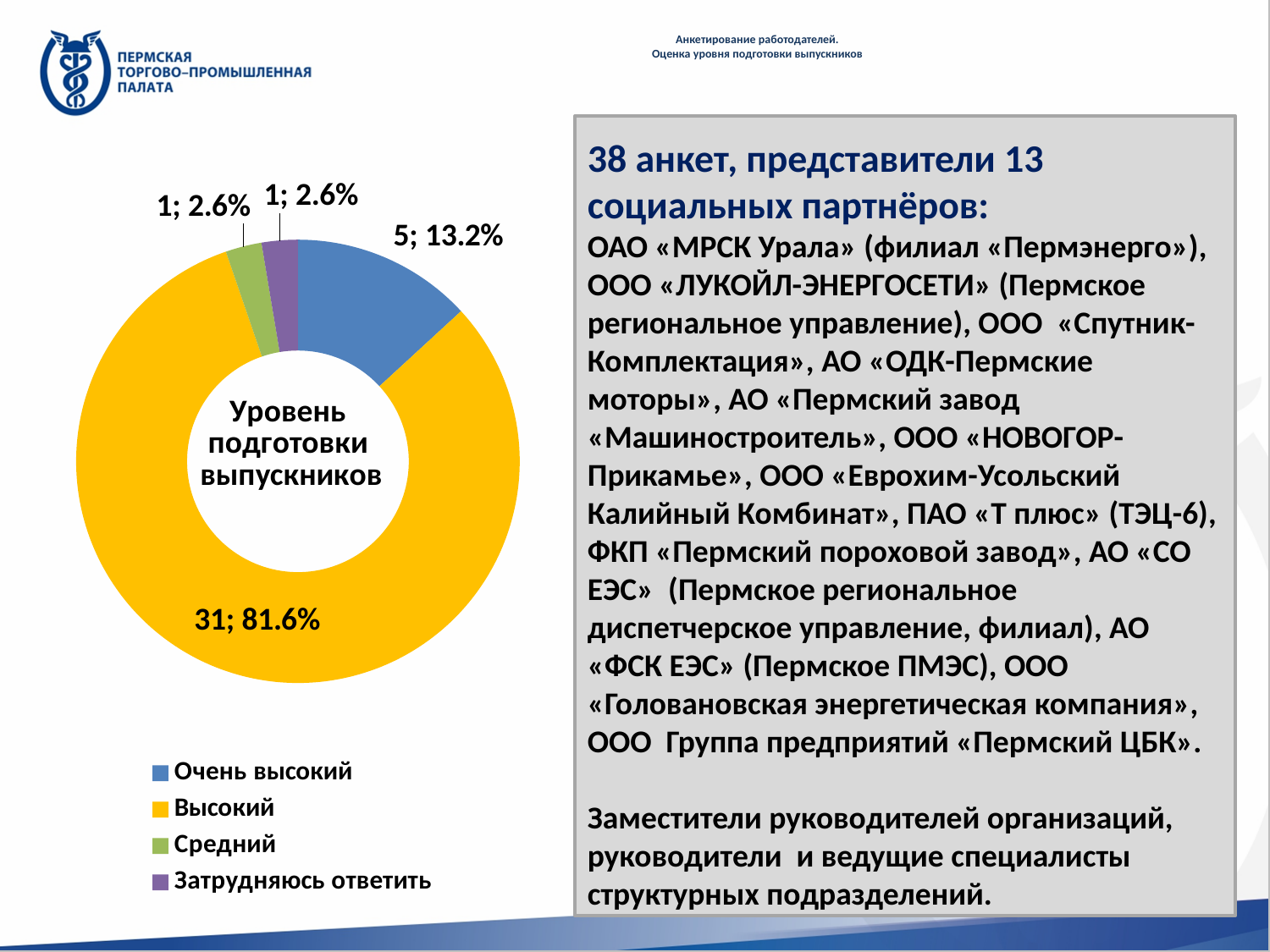
What colour represents the "Затрудняюсь ответить" category? Purple Which is larger, the "Очень высокий" slice or the "Средний" slice? Очень высокий What percentage share does the "Высокий" slice have? 81.6% How many responses are in the "Высокий" category? 31 What percentage share does the "Очень высокий" slice have? 13.2% What kind of chart is shown on the slide? Doughnut (pie) chart What percentage share does the "Средний" slice have? 2.6% Which category has the largest slice? Высокий How many responses are in the "Очень высокий" category? 5 How many categories does the chart's legend list? 4 What is the difference in number of responses between "Высокий" and "Очень высокий"? 26 What is the title shown in the centre of the chart? Уровень подготовки выпускников